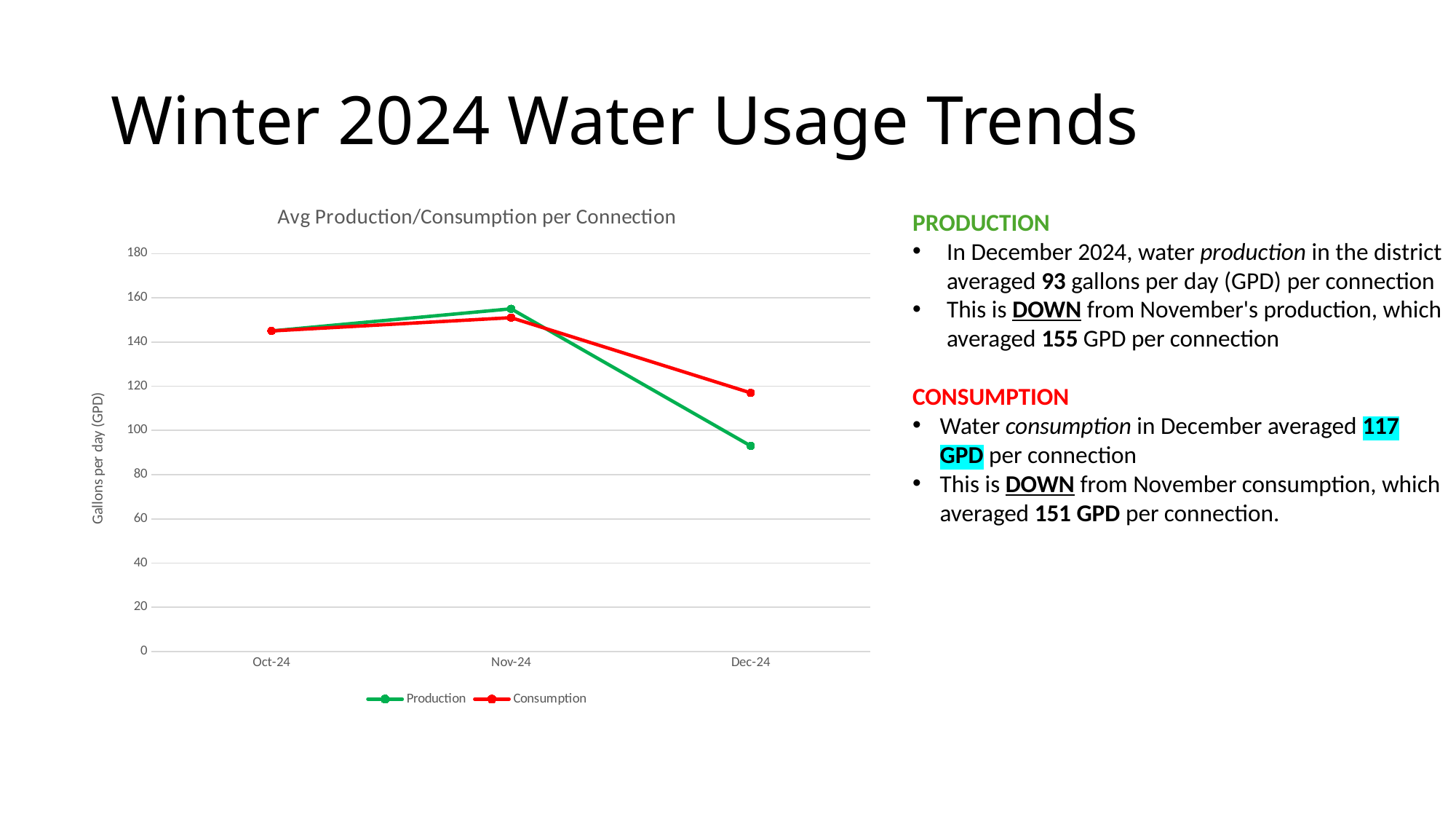
How many months are plotted along the x axis of the chart? 3 How many series does the chart legend list? 2 Does the Consumption line rise or fall from Nov-24 to Dec-24? fall In Dec-24, which is higher: Production or Consumption? Consumption What was the average water consumption per connection in Dec-24, according to the slide? 117 GPD What is the title of the chart? Avg Production/Consumption per Connection What was the average water production per connection in Dec-24, according to the slide? 93 GPD What was the average production per connection in Nov-24, according to the slide? 155 GPD By how much did production per connection fall from Nov-24 to Dec-24? 62 GPD Is the Production value for Oct-24 greater or less than 120? greater What kind of chart is shown on the slide? line chart In which month is Production at its highest? Nov-24